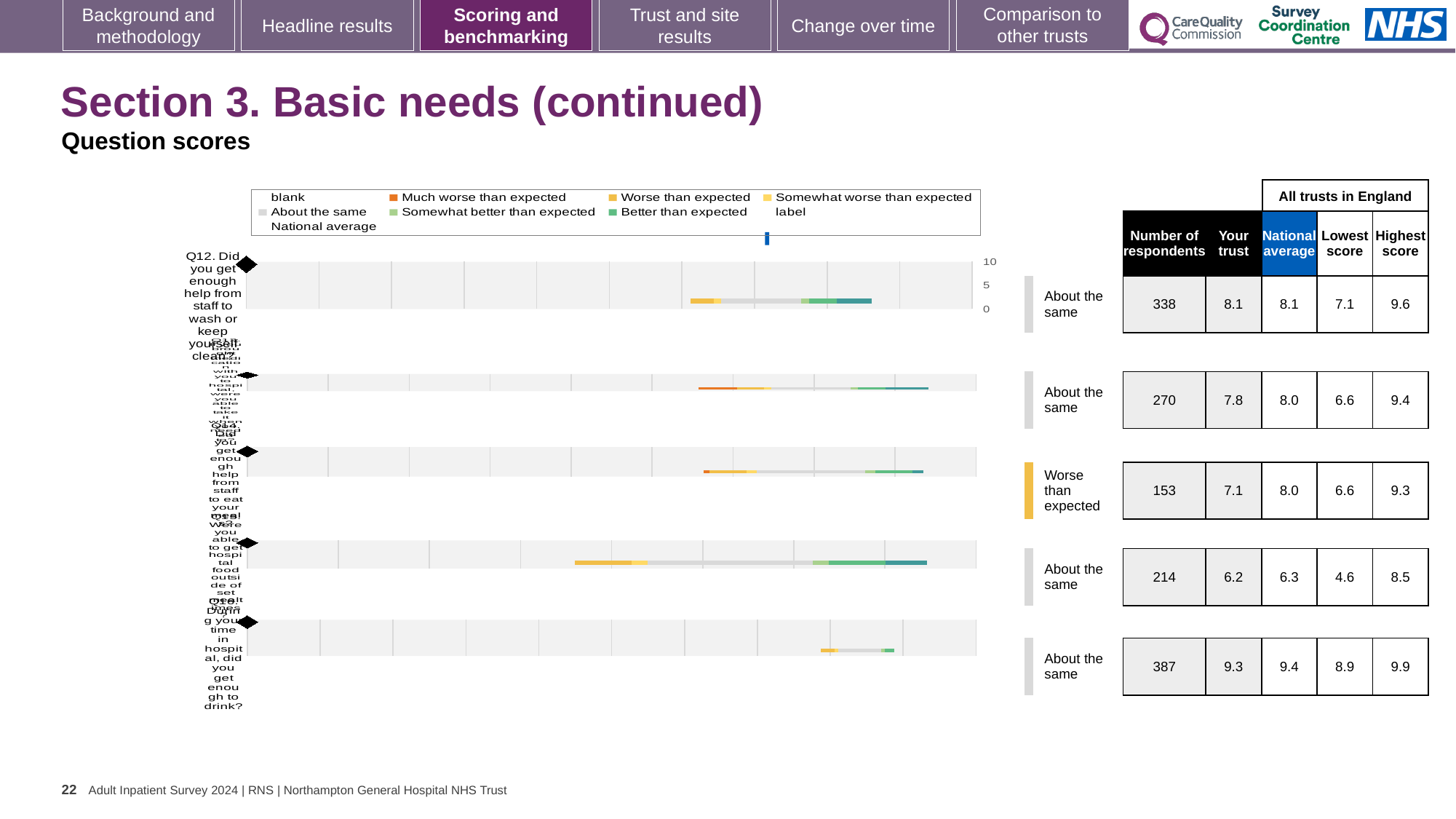
Which benchmark category is given to the third question bar (153 respondents)? Worse than expected For the third question bar (153 respondents), is the 'Your trust' score or the national average larger? National average What is the 'Your trust' score for Q12 (Did you get enough help from staff to wash or keep yourself clean?)? 8.1 What is the highest 'Your trust' score among the five questions shown? 9.3 How many question bars are plotted in the chart? 5 How many respondents answered Q12 (Did you get enough help from staff to wash or keep yourself clean?)? 338 What kind of chart is shown on the slide? bar chart What is the national average for Q12 (Did you get enough help from staff to wash or keep yourself clean?)? 8.1 How many of the five questions are rated 'About the same'? 4 What is the lowest 'Your trust' score among the five questions shown? 6.2 What is the difference between the highest score and the lowest score for Q12 (Did you get enough help from staff to wash or keep yourself clean?)? 2.5 Which legend entry is shown in orange? Much worse than expected